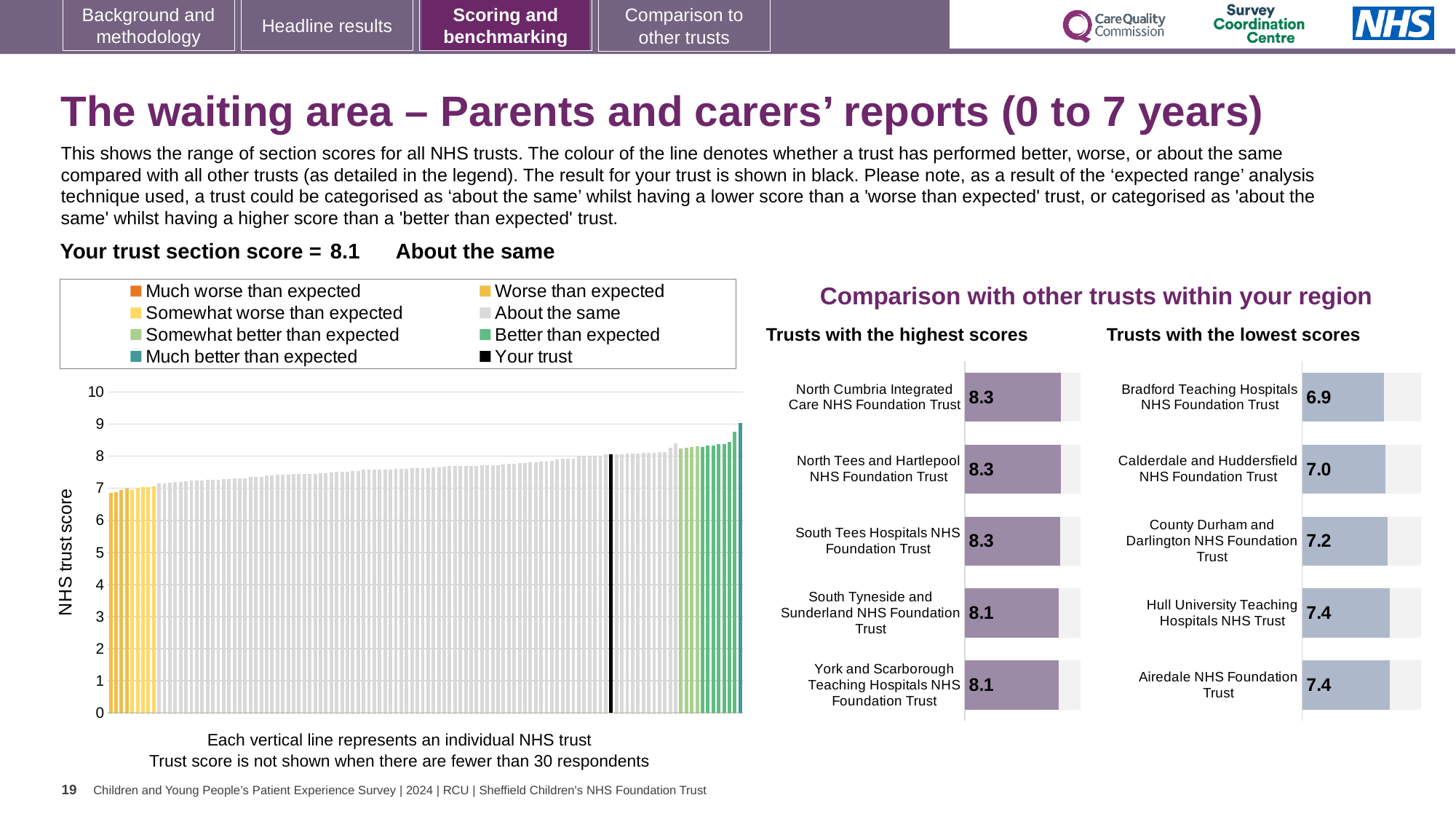
On the 'Trusts with the lowest scores' chart, which has the higher score: Calderdale and Huddersfield NHS Foundation Trust or County Durham and Darlington NHS Foundation Trust? County Durham and Darlington NHS Foundation Trust On the 'Trusts with the lowest scores' chart, what is the difference between the scores of Hull University Teaching Hospitals NHS Trust and Bradford Teaching Hospitals NHS Foundation Trust? 0.5 On the 'Trusts with the highest scores' chart, what is the score for York and Scarborough Teaching Hospitals NHS Foundation Trust? 8.1 On the large chart on the left, is the value of the tallest bar greater or less than 8? greater On the large chart on the left, do the trust scores rise or fall from left to right? Rise What kind of chart is the large chart on the left showing NHS trust scores? Bar chart How many entries does the legend above the large chart on the left list? 8 On the 'Trusts with the lowest scores' chart, which trust has the lowest score? Bradford Teaching Hospitals NHS Foundation Trust On the 'Trusts with the lowest scores' chart, what is the score for Bradford Teaching Hospitals NHS Foundation Trust? 6.9 On the 'Trusts with the highest scores' chart, what is the difference between the scores of North Tees and Hartlepool NHS Foundation Trust and South Tyneside and Sunderland NHS Foundation Trust? 0.2 How many trusts are listed on the 'Trusts with the highest scores' chart? 5 On the 'Trusts with the highest scores' chart, what is the score for North Cumbria Integrated Care NHS Foundation Trust? 8.3